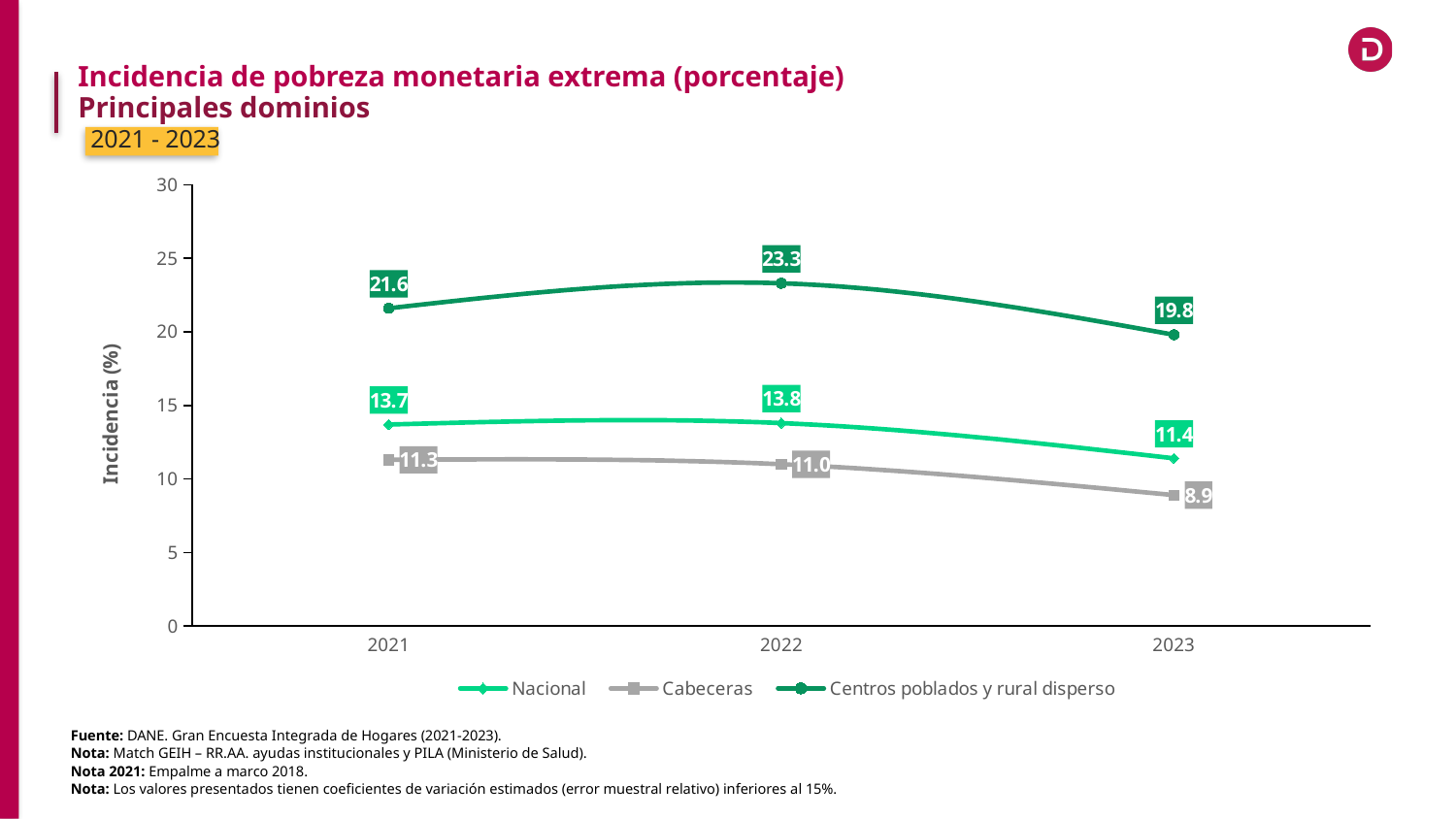
Is the value for Centros poblados y rural disperso in 2023 greater or less than 15? greater What is the difference between the Centros poblados y rural disperso value in 2022 and in 2023? 3.5 What is the value for Cabeceras in 2021? 11.3 In which year is the value for Cabeceras lowest? 2023 Which is larger in 2021: the value for Nacional or the value for Cabeceras? Nacional In which year is the value for Centros poblados y rural disperso highest? 2022 How many series does the legend list? 3 What is the value for Centros poblados y rural disperso in 2022? 23.3 How many years are shown on the x axis? 3 What is the value for Nacional in 2023? 11.4 What kind of chart is shown on the slide? Line chart Does the Nacional series rise or fall from 2022 to 2023? Fall